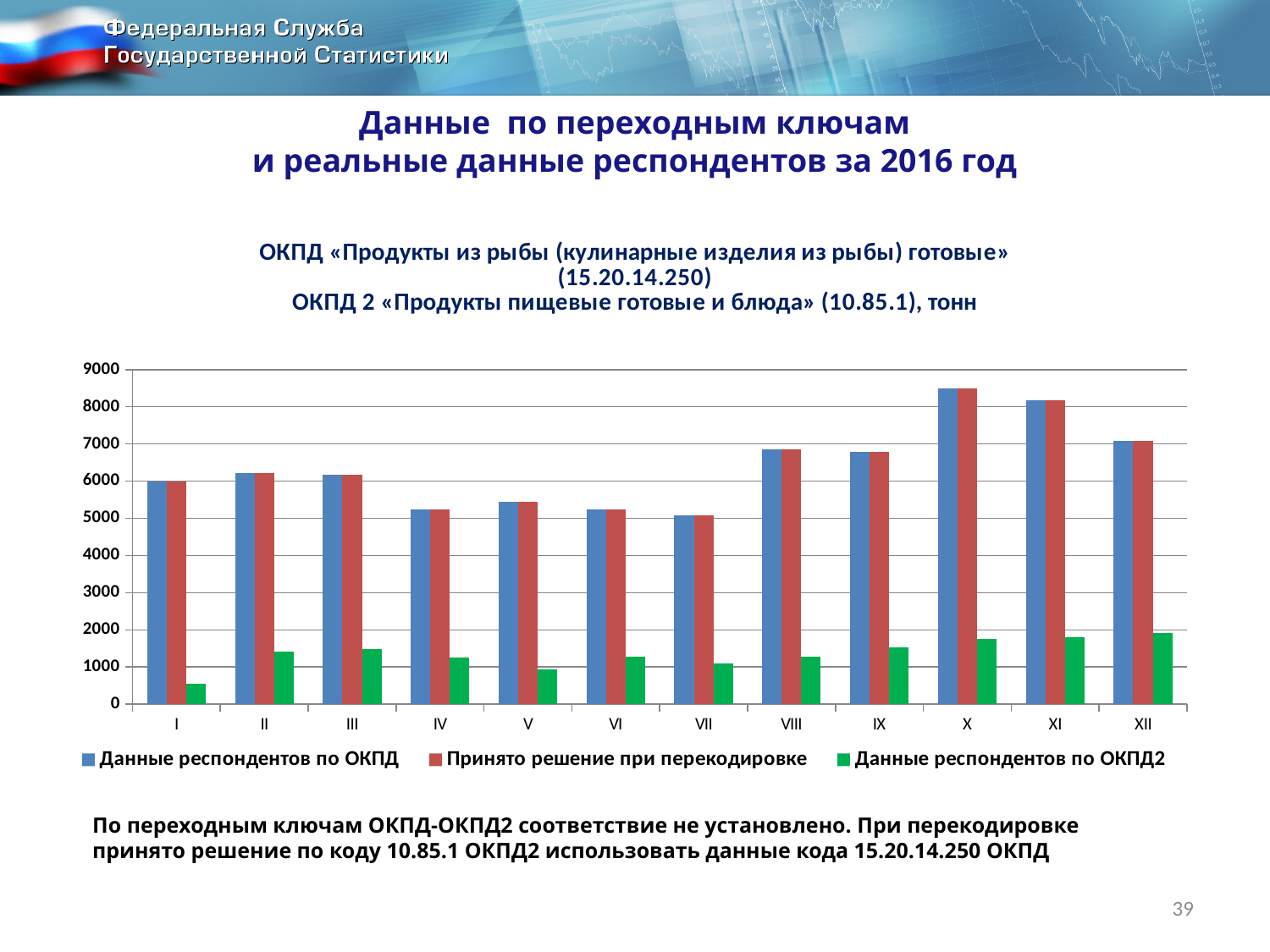
How many categories (months) are shown on the x axis? 12 How many series does the legend list? 3 Which month has the highest value for "Данные респондентов по ОКПД"? X What colour are the bars for "Данные респондентов по ОКПД2"? green Is the value for "Данные респондентов по ОКПД2" in month XII greater or less than 1000? greater Which is larger for "Данные респондентов по ОКПД": month II or month V? month II Is the value for "Данные респондентов по ОКПД2" in month I greater or less than 1000? less Is the value for "Данные респондентов по ОКПД" in month X greater or less than 8000? greater Which month has the lowest value for "Данные респондентов по ОКПД2"? I What kind of chart is shown on the slide? bar chart Do the values for "Данные респондентов по ОКПД" rise or fall from month VII to month X? rise